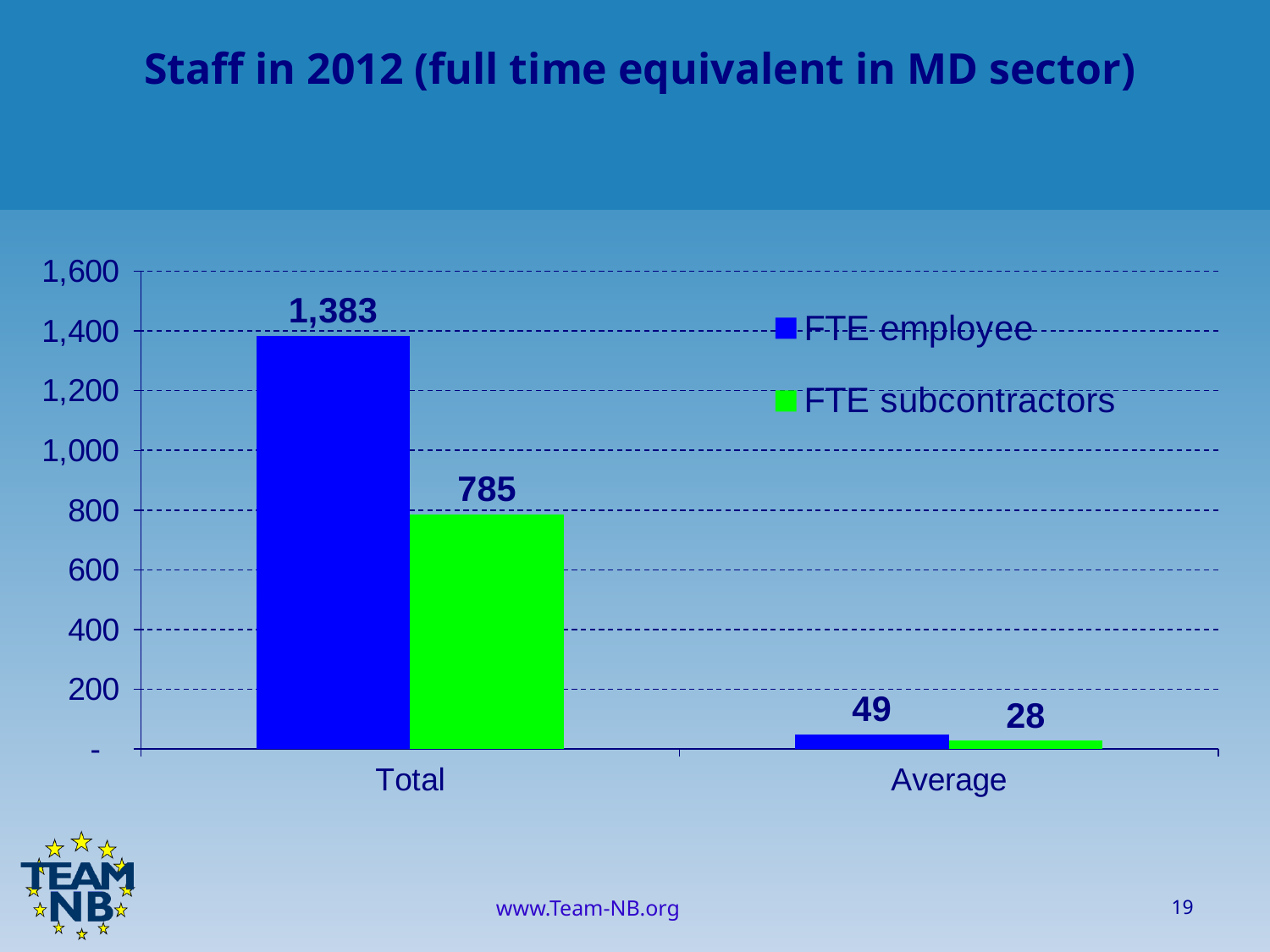
Which category has the lowest FTE subcontractors value? Average What is the FTE employee value for Average? 49 Which category has the highest FTE employee value? Total What is the difference between the FTE employee and FTE subcontractors values for Total? 598 What is the FTE subcontractors value for Average? 28 How many series does the legend list? 2 How many categories are shown on the x axis? 2 What kind of chart is shown on the slide? Bar chart What is the difference between the FTE employee and FTE subcontractors values for Average? 21 For Total, which is larger: FTE employee or FTE subcontractors? FTE employee What is the FTE subcontractors value for Total? 785 What is the FTE employee value for Total? 1,383